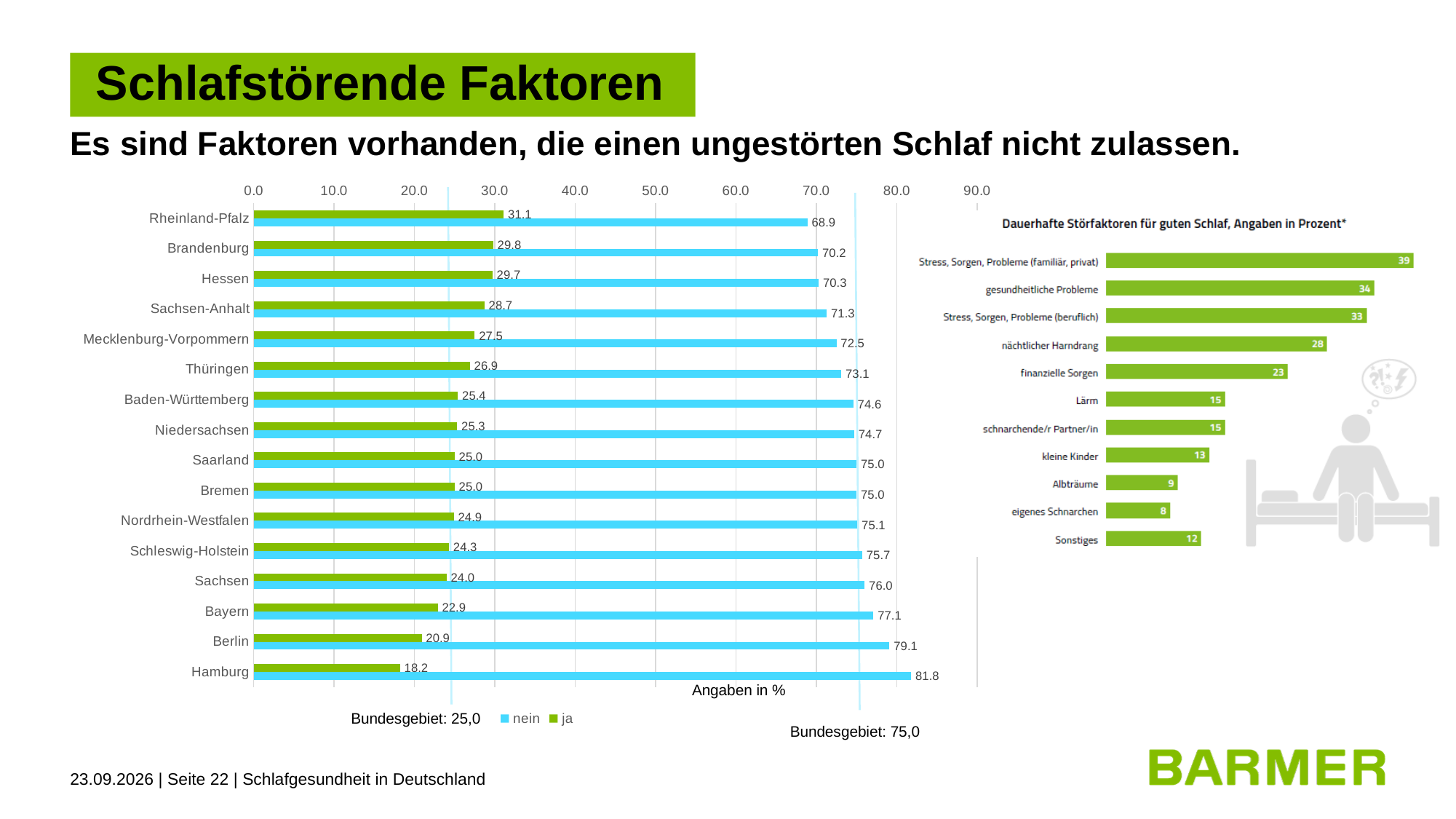
In the left chart of German states, what is the 'nein' value for Hamburg? 81.8 In the left chart of German states, how many states are listed? 16 In the left chart of German states, how many series does the legend list? 2 In the left chart of German states, which state has the highest 'nein' value? Hamburg In the left chart of German states, which is larger: the 'ja' value for Hessen or the 'ja' value for Sachsen? Hessen In the right chart 'Dauerhafte Störfaktoren für guten Schlaf', which factor has the highest value? Stress, Sorgen, Probleme (familiär, privat) What kind of chart is the left chart of German states? Bar chart In the left chart of German states, what is the 'ja' value for Rheinland-Pfalz? 31.1 In the left chart of German states, which state has the lowest 'ja' value? Hamburg In the right chart 'Dauerhafte Störfaktoren für guten Schlaf', what is the value for 'nächtlicher Harndrang'? 28 In the right chart 'Dauerhafte Störfaktoren für guten Schlaf', how many factors are listed? 11 In the left chart of German states, what is the difference between the 'nein' values for Berlin and Bayern? 2.0